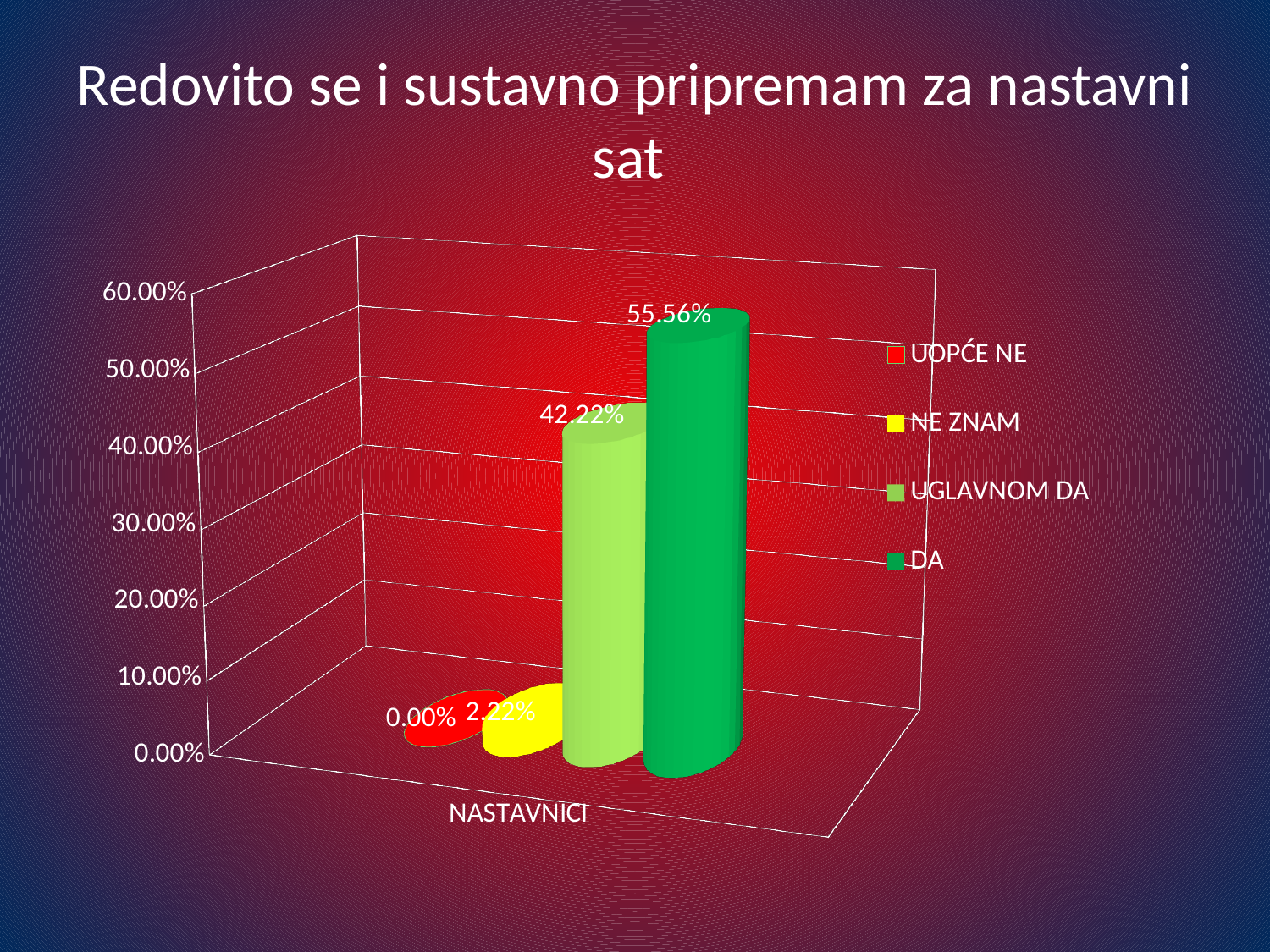
What kind of chart is shown on the slide? Bar chart What is the value for UGLAVNOM DA? 42.22% What is the value for DA? 55.56% Which is larger, the value for UGLAVNOM DA or the value for NE ZNAM? UGLAVNOM DA What is the difference between the values for DA and UGLAVNOM DA? 13.34% What is the title of the chart? Redovito se i sustavno pripremam za nastavni sat Which series has the lowest value? UOPĆE NE What is the value for UOPĆE NE? 0.00% How many series does the legend list? 4 Which series has the highest value? DA What is the category label on the x axis? NASTAVNICI What is the value for NE ZNAM? 2.22%